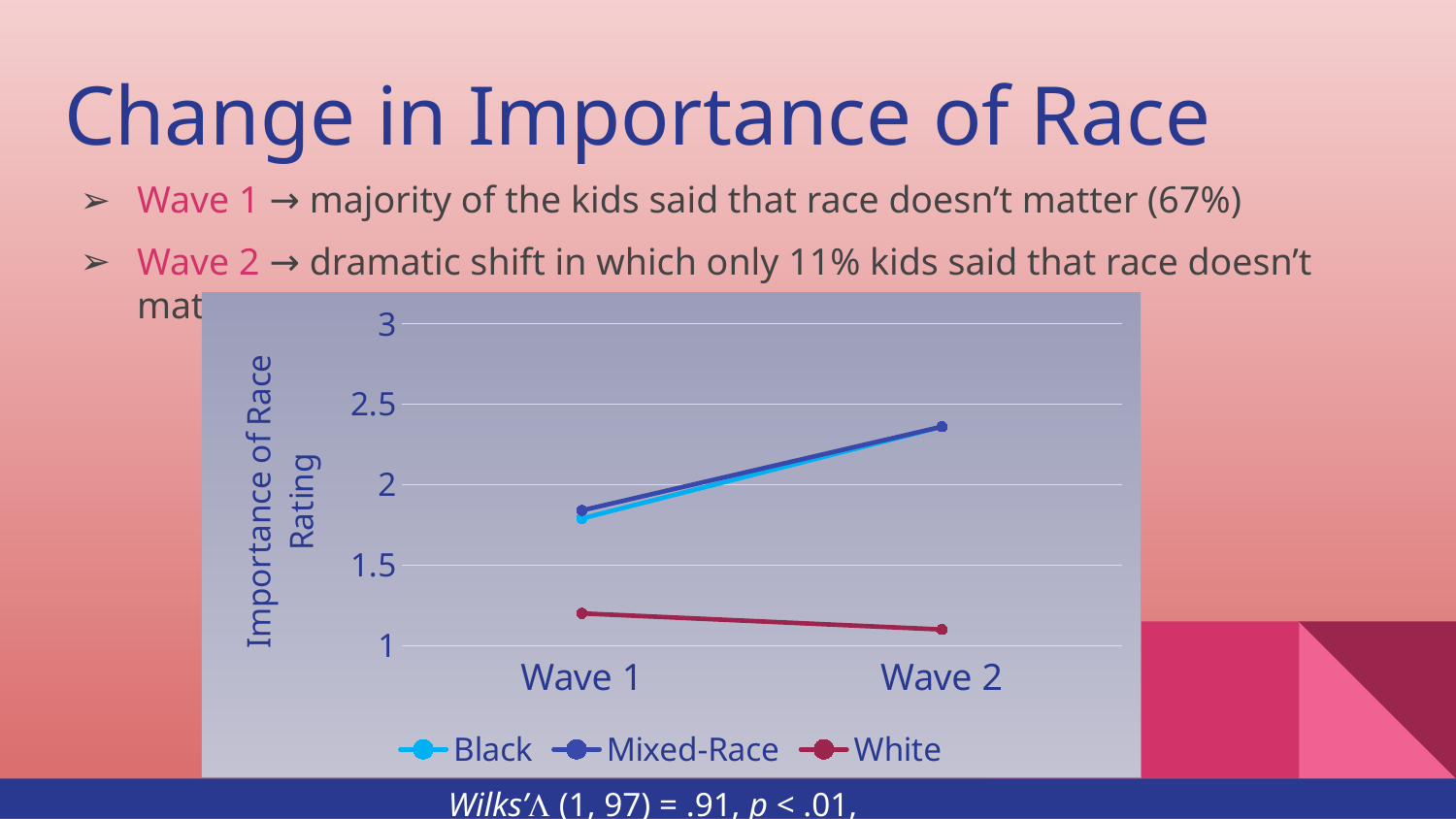
Which series are listed in the chart's legend? Black, Mixed-Race, White How many series does the chart's legend list? 3 Does the Mixed-Race series rise or fall from Wave 1 to Wave 2? rise What kind of chart is shown on the slide? line chart Is the value for Black at Wave 1 greater or less than 2? less Is the value for White at Wave 2 greater or less than 1.5? less Which series has the lowest value at Wave 1? White Does the Black series rise or fall from Wave 1 to Wave 2? rise Is the value for Mixed-Race at Wave 2 greater or less than 2? greater Does the White series rise or fall from Wave 1 to Wave 2? fall What is the title of the chart's vertical axis? Importance of Race Rating How many categories are shown on the x axis of the chart? 2